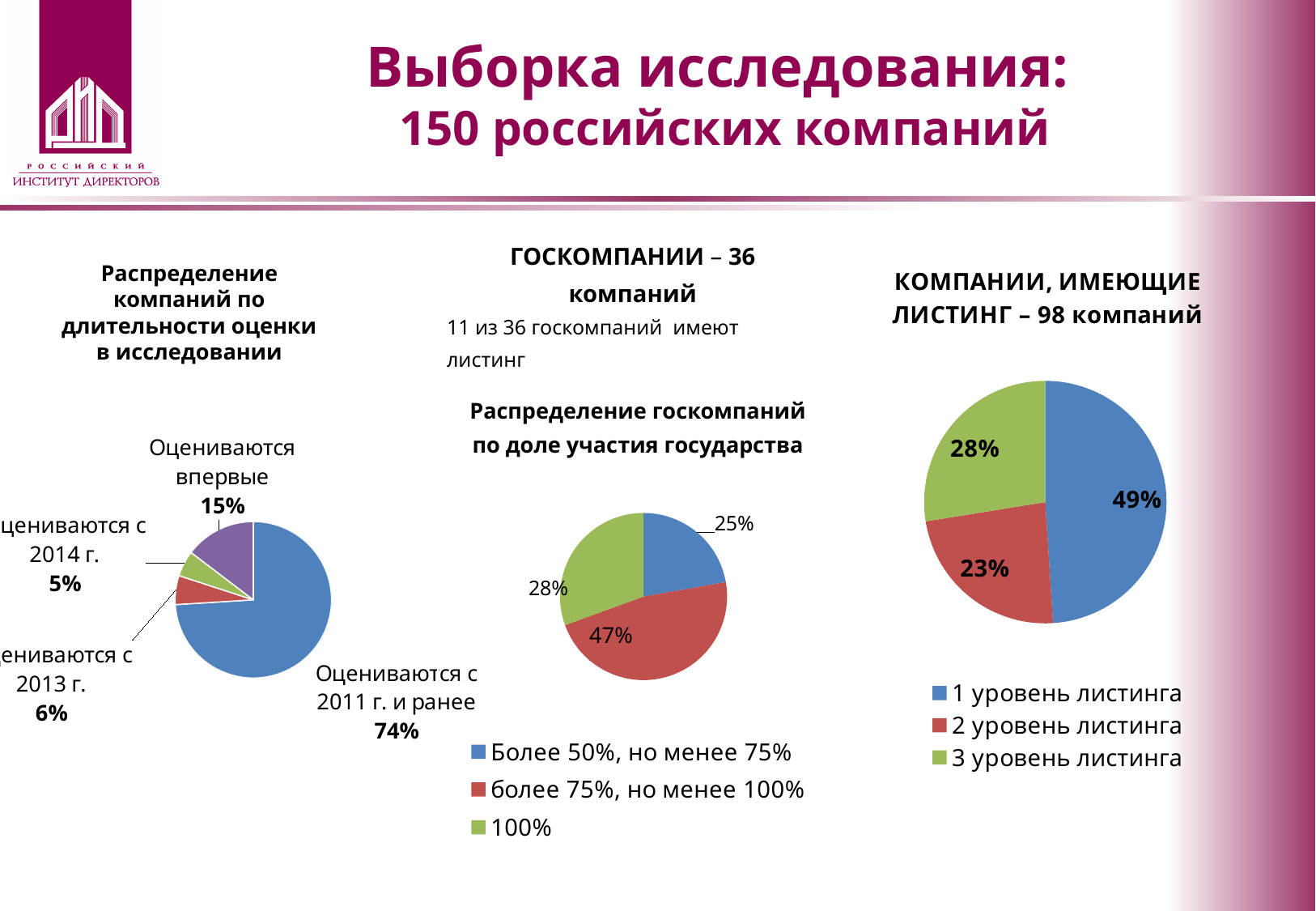
In the left pie chart, which category has the smallest share? Оцениваются с 2014 г. In the right pie chart, which is larger: the share for 2 уровень листинга or 3 уровень листинга? 3 уровень листинга In the middle pie chart, which category has the largest share? более 75%, но менее 100% In the right pie chart, what is the difference between the shares for 1 уровень листинга and 2 уровень листинга? 26% In the middle pie chart, how many categories does the legend list? 3 In the middle pie chart (Распределение госкомпаний по доле участия государства), what share of state companies have 100% state participation? 28% In the left pie chart (Распределение компаний по длительности оценки в исследовании), what share of companies are evaluated since 2011 or earlier (Оцениваются с 2011 г. и ранее)? 74% In the left pie chart, which category has the largest share? Оцениваются с 2011 г. и ранее In the right pie chart (Компании, имеющие листинг – 98 компаний), what share of companies are at the 1st listing level (1 уровень листинга)? 49% In the left pie chart, what is the difference between the share evaluated for the first time and the share evaluated since 2013? 9% What type of chart is used for the right chart (Компании, имеющие листинг)? Pie chart In the left pie chart, what share of companies are evaluated for the first time (Оцениваются впервые)? 15%